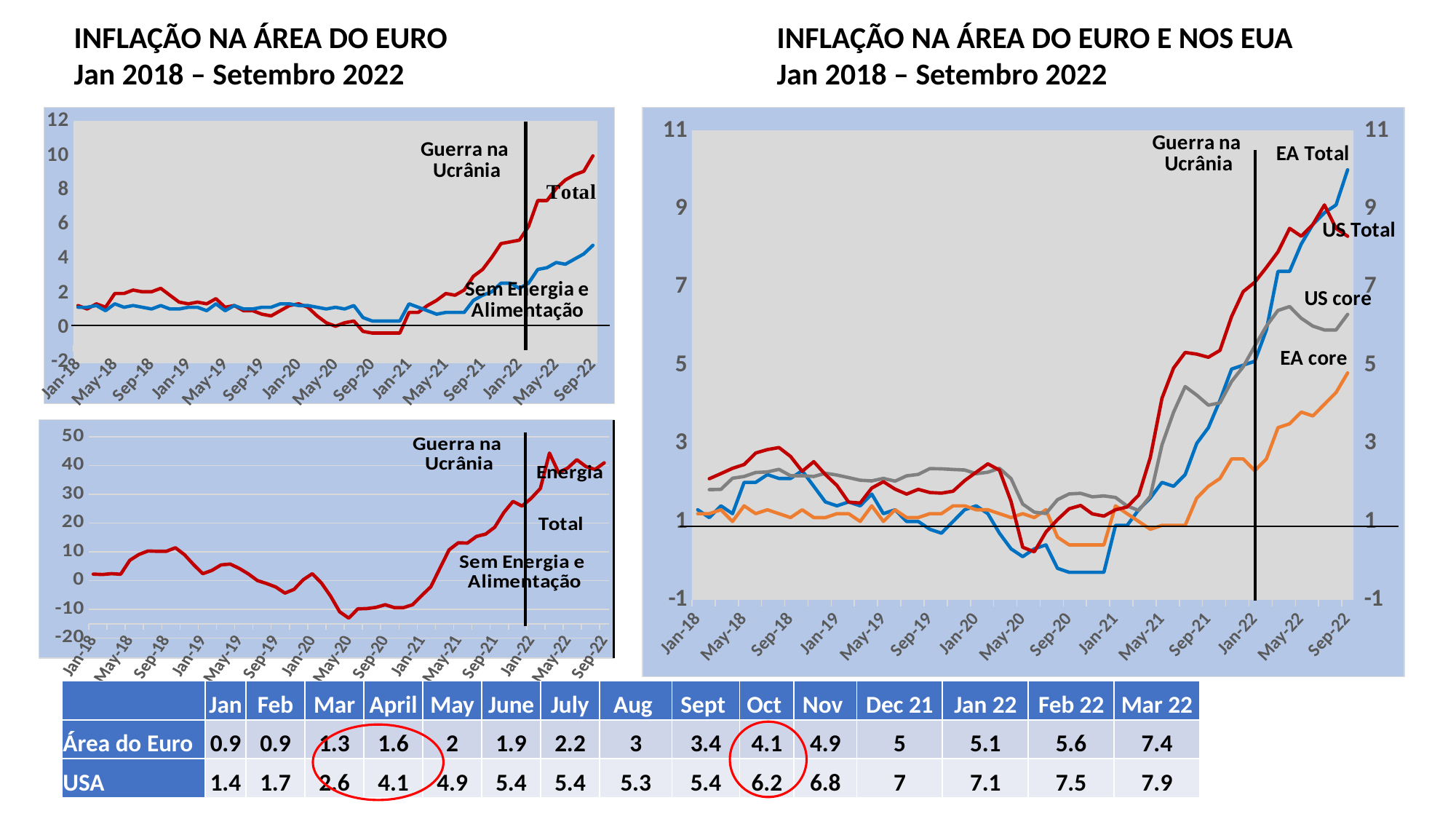
In the right chart 'INFLAÇÃO NA ÁREA DO EURO E NOS EUA', which is higher at Sep-22, US core or EA core? US core In the table at the bottom of the slide, what is the difference between the USA and Área do Euro values in April? 2.5 What event does the vertical black line in each chart mark? Guerra na Ucrânia In the right chart 'INFLAÇÃO NA ÁREA DO EURO E NOS EUA', how many series are labelled? 4 In the table at the bottom of the slide, what is the value for Área do Euro in Mar 22? 7.4 In the right chart 'INFLAÇÃO NA ÁREA DO EURO E NOS EUA', is the value of US Total at Sep-22 greater or less than 9? less What kind of chart is the top-left chart titled 'INFLAÇÃO NA ÁREA DO EURO'? line chart In the right chart 'INFLAÇÃO NA ÁREA DO EURO E NOS EUA', is the value of EA Total at Sep-22 greater or less than 9? greater In the top-left chart 'INFLAÇÃO NA ÁREA DO EURO', is the value of Total at Sep-22 greater or less than 8? greater In the top-left chart 'INFLAÇÃO NA ÁREA DO EURO', does the Total series rise or fall between Jan-21 and Sep-22? rise In the right chart 'INFLAÇÃO NA ÁREA DO EURO E NOS EUA', which is higher at Sep-22, EA Total or US Total? EA Total